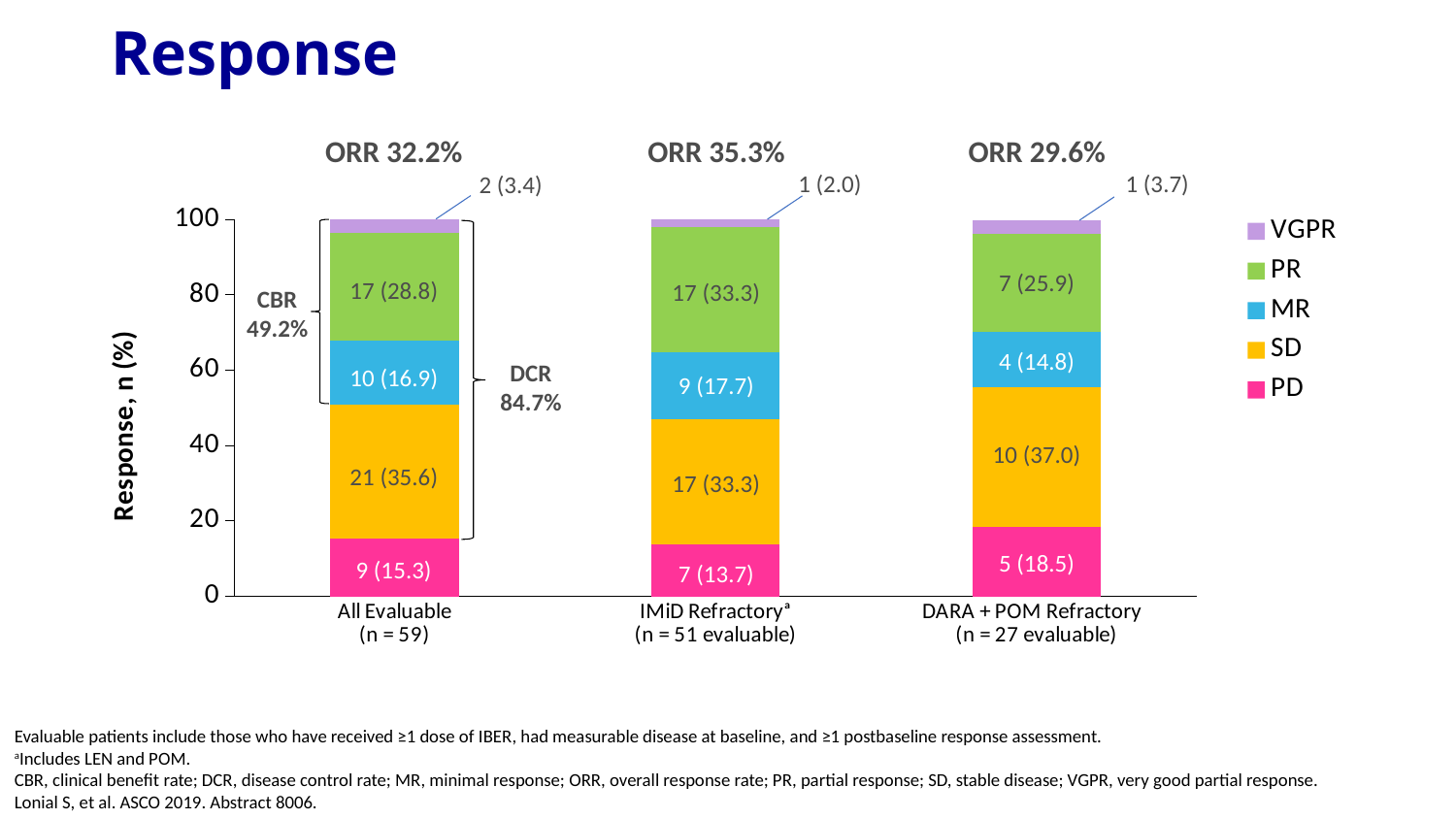
What is the difference in PR patient count between the All Evaluable group and the DARA + POM Refractory group? 10 What is the PR value labelled for the All Evaluable (n = 59) group? 17 (28.8) What ORR is shown above the IMiD Refractory bar? ORR 35.3% What type of chart is shown on the slide? Stacked bar chart Which response category is the smallest segment in the IMiD Refractory bar? VGPR Which response category is the largest segment in the DARA + POM Refractory bar? SD What is the SD value labelled for the DARA + POM Refractory group? 10 (37.0) How many series does the legend list? 5 What is the VGPR value labelled for the All Evaluable group? 2 (3.4) How many patient groups (categories) are shown on the x axis? 3 What is the PD value labelled for the IMiD Refractory group? 7 (13.7) Which group has the larger SD count, All Evaluable or IMiD Refractory? All Evaluable